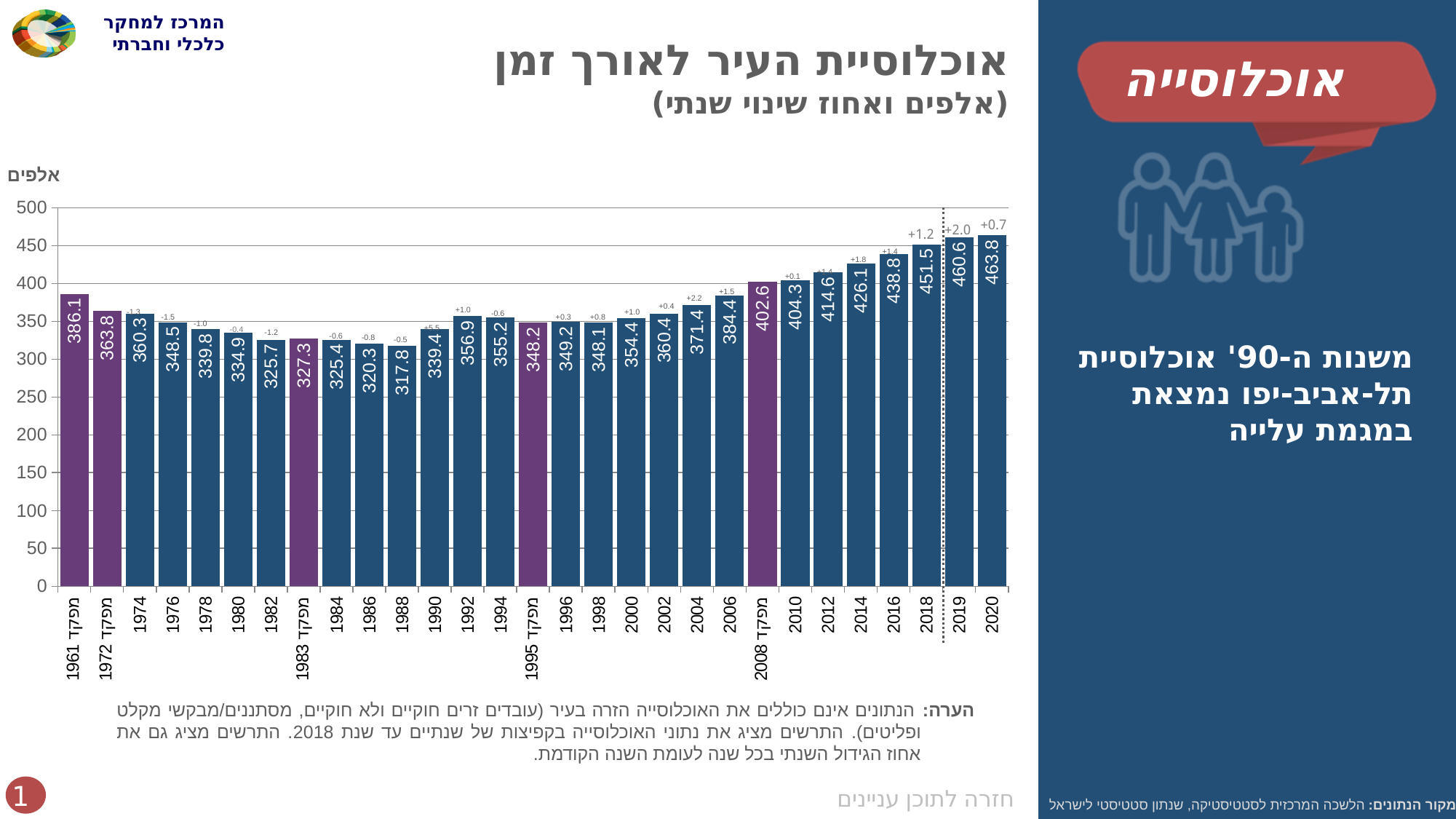
What is the population value shown for 1988? 317.8 Which year has the highest population value in the chart? 2020 What type of chart is shown on the slide? bar chart Which year has the lowest population value in the chart? 1988 What is the unit label shown above the y-axis of the chart? אלפים How many bars (years) are plotted in the chart? 29 What is the population value (in thousands) shown for 2020? 463.8 Which is larger, the population value for 1961 or for 2008? 2008 Do the population values rise or fall from 2008 to 2020? rise What annual percent change is labelled above the 2019 bar? +2.0 What is the difference between the population values for 2020 and 2018? 12.3 What is the population value shown for the 1961 census (מפקד 1961)? 386.1